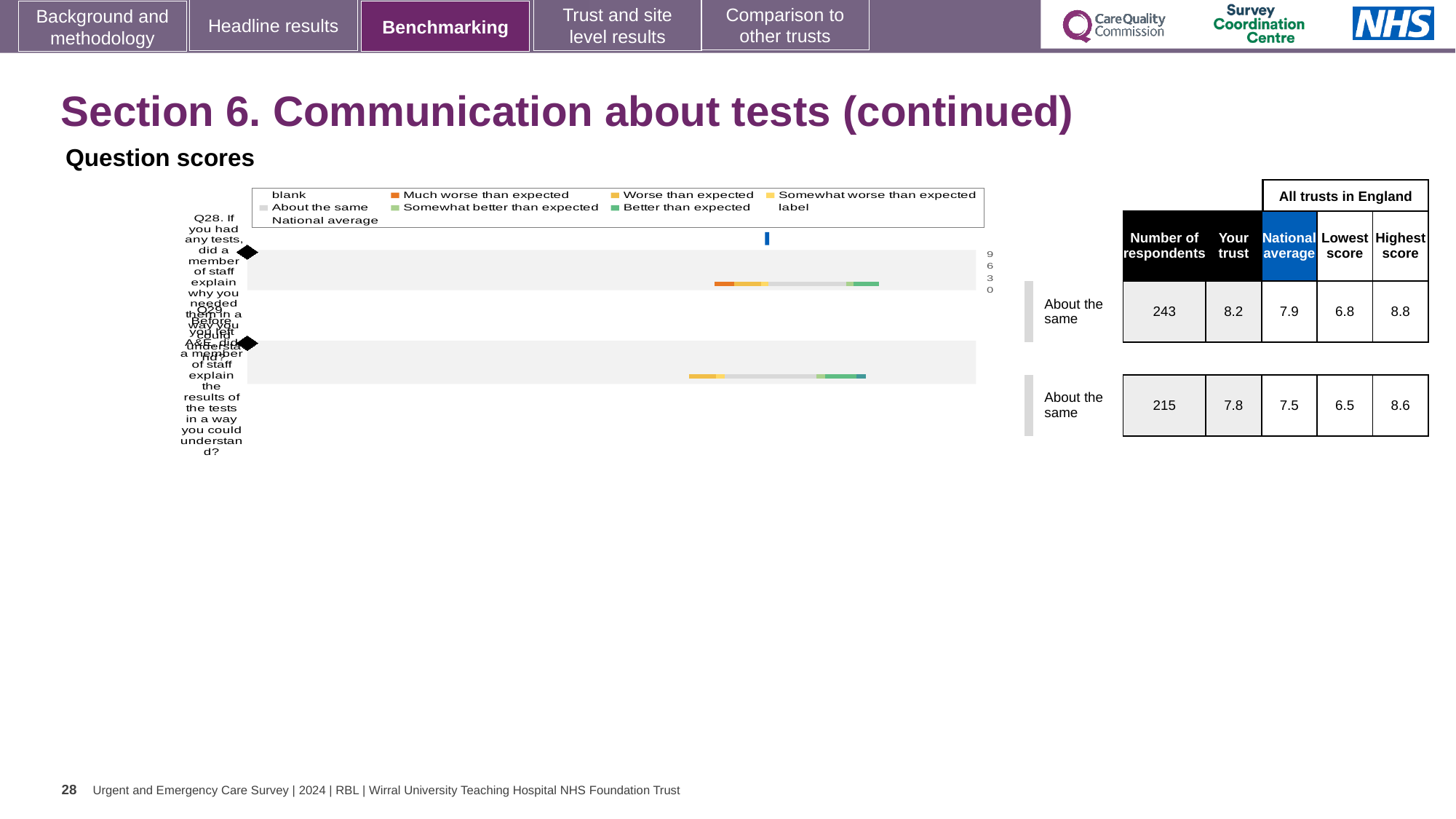
What is the 'Your trust' score for Q28? 8.2 In the question scores chart legend, what colour represents 'Much worse than expected'? orange How many questions (categories) are plotted in the question scores chart? 2 In the question scores chart legend, what colour represents 'Better than expected'? green What is the national average score for Q29? 7.5 What kind of chart is used to show the question scores for Q28 and Q29? bar chart What is the benchmarking category shown for Q29 (explaining the results of the tests)? About the same What is the benchmarking category shown for Q28 (explaining why you needed tests)? About the same How many respondents answered Q28? 243 What is the 'Your trust' score for Q29? 7.8 What is the difference between the 'Your trust' score and the national average for Q28? 0.3 Which question has the higher 'Your trust' score, Q28 or Q29? Q28